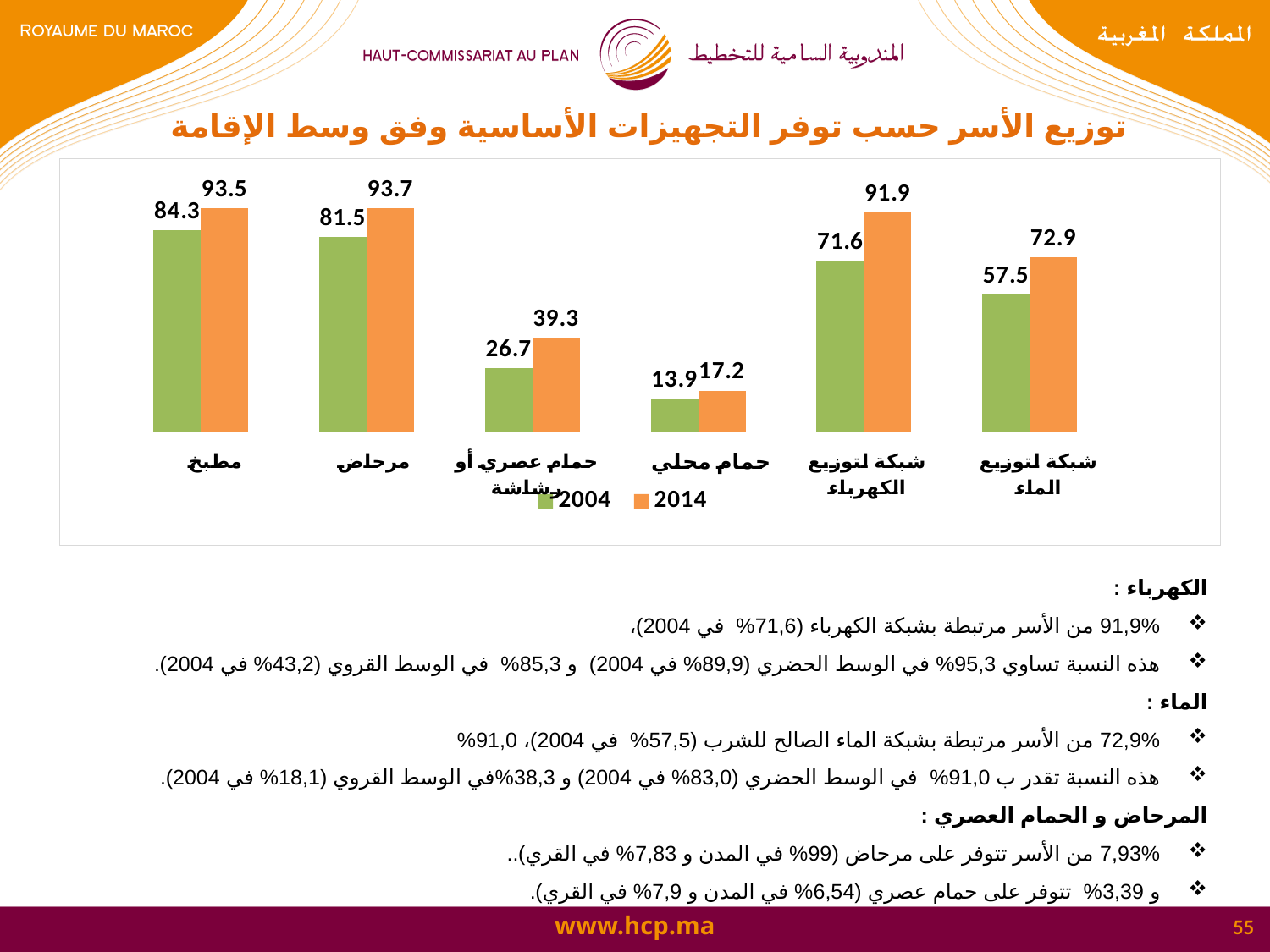
What is the 2014 value for شبكة لتوزيع الكهرباء? 91.9 What kind of chart is shown on the slide? bar chart Which colour represents the 2014 series in the legend? orange How many categories are shown on the x axis? 6 What is the 2004 value for شبكة لتوزيع الماء? 57.5 Which category has the highest 2014 value? مرحاض How many series does the legend list? 2 Which category has the lowest 2004 value? حمام محلي Which is larger: the 2004 value for مطبخ or the 2004 value for مرحاض? مطبخ What is the difference between the 2014 and 2004 values for حمام عصري أو رشاشة? 12.6 What is the 2004 value for حمام محلي? 13.9 What is the difference between the 2014 and 2004 values for شبكة لتوزيع الكهرباء? 20.3